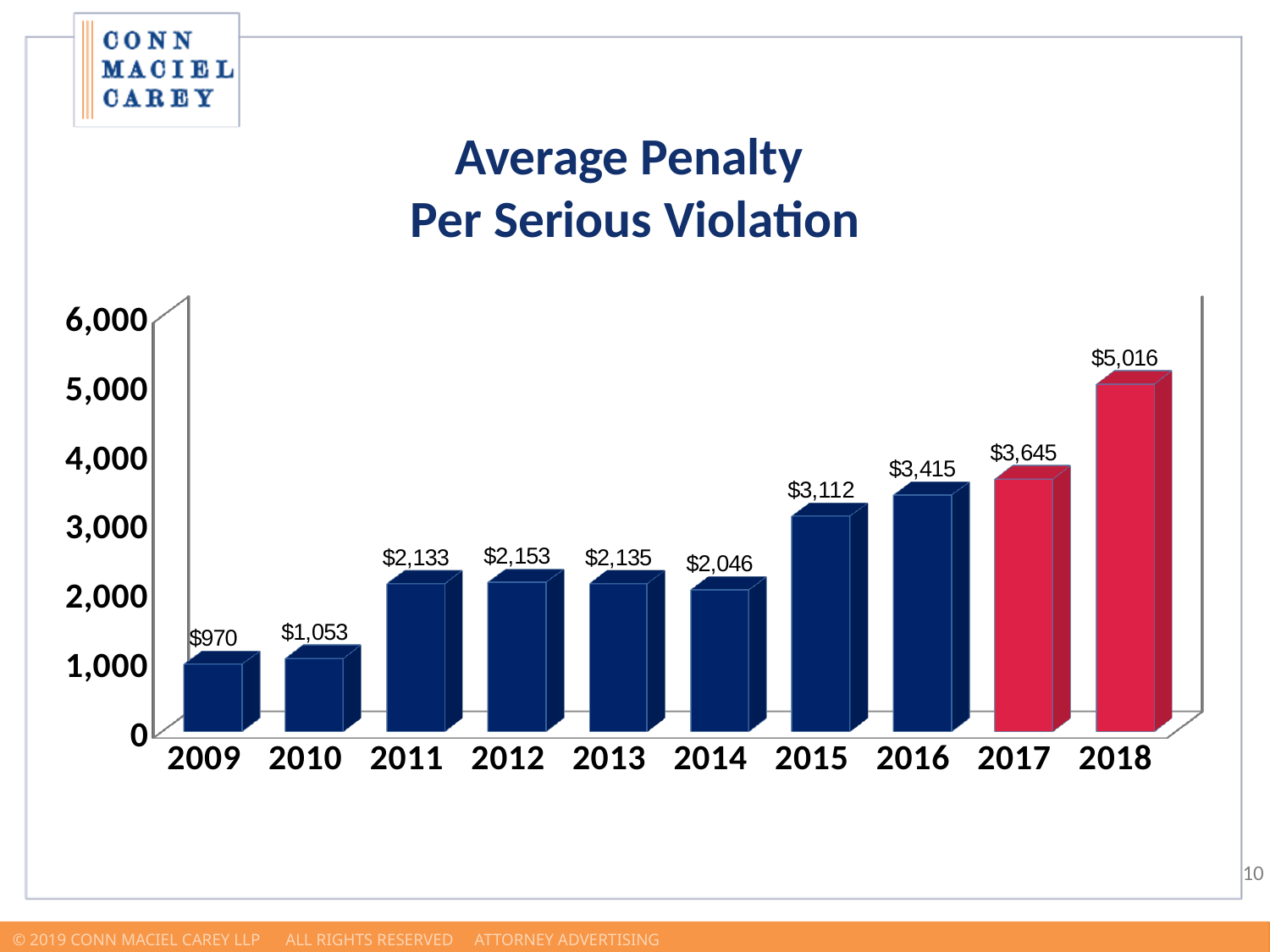
Is the value for 2017 greater or less than 3,000? greater Which year has the highest average penalty per serious violation? 2018 Which years are shown with red bars instead of blue? 2017 and 2018 What is the average penalty per serious violation for 2009? $970 What kind of chart is shown on the slide? Bar chart How many years are shown on the chart? 10 Which year has the lowest average penalty per serious violation? 2009 Do the values generally rise or fall from 2009 to 2018? Rise What is the average penalty per serious violation for 2014? $2,046 What is the average penalty per serious violation for 2018? $5,016 What is the difference between the average penalty in 2018 and in 2017? $1,371 Which year has a larger average penalty, 2015 or 2016? 2016